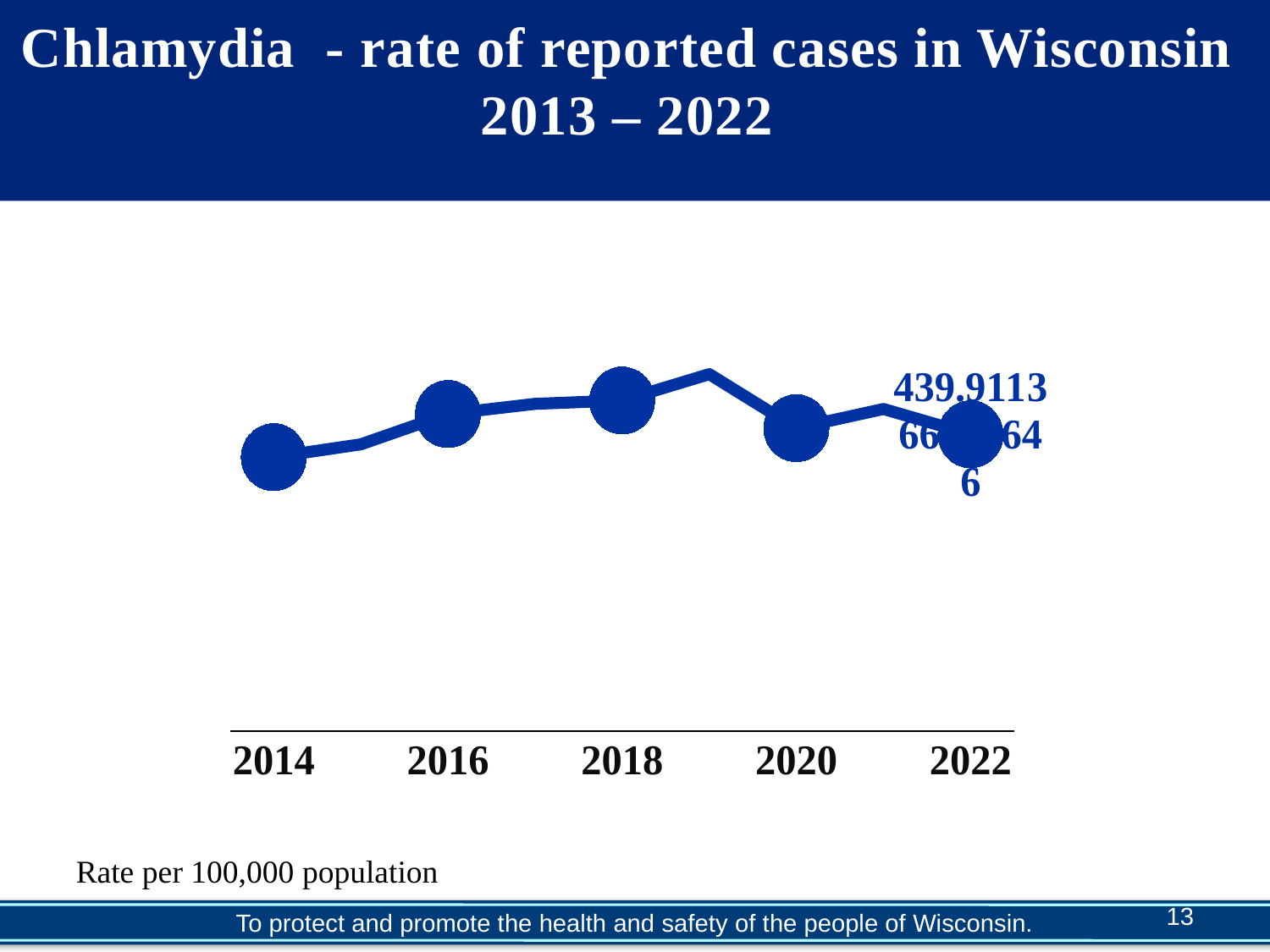
Is the value for 2018 higher or lower than the value for 2014? higher Of the years labelled on the x axis, which has the highest plotted value? 2018 What kind of chart is shown on the slide? line chart Does the line rise or fall from 2014 to 2018? rise What unit is the rate expressed in, according to the note below the chart? Rate per 100,000 population Is the value for 2016 higher or lower than the value for 2014? higher What is the title of the chart on the slide? Chlamydia - rate of reported cases in Wisconsin 2013 – 2022 Does the line rise or fall from 2018 to 2020? fall What is the first year labelled on the x axis? 2014 How many year labels are shown on the x axis? 5 Is the value for 2020 higher or lower than the value for 2018? lower Which year labelled on the x axis has the lowest plotted value? 2014